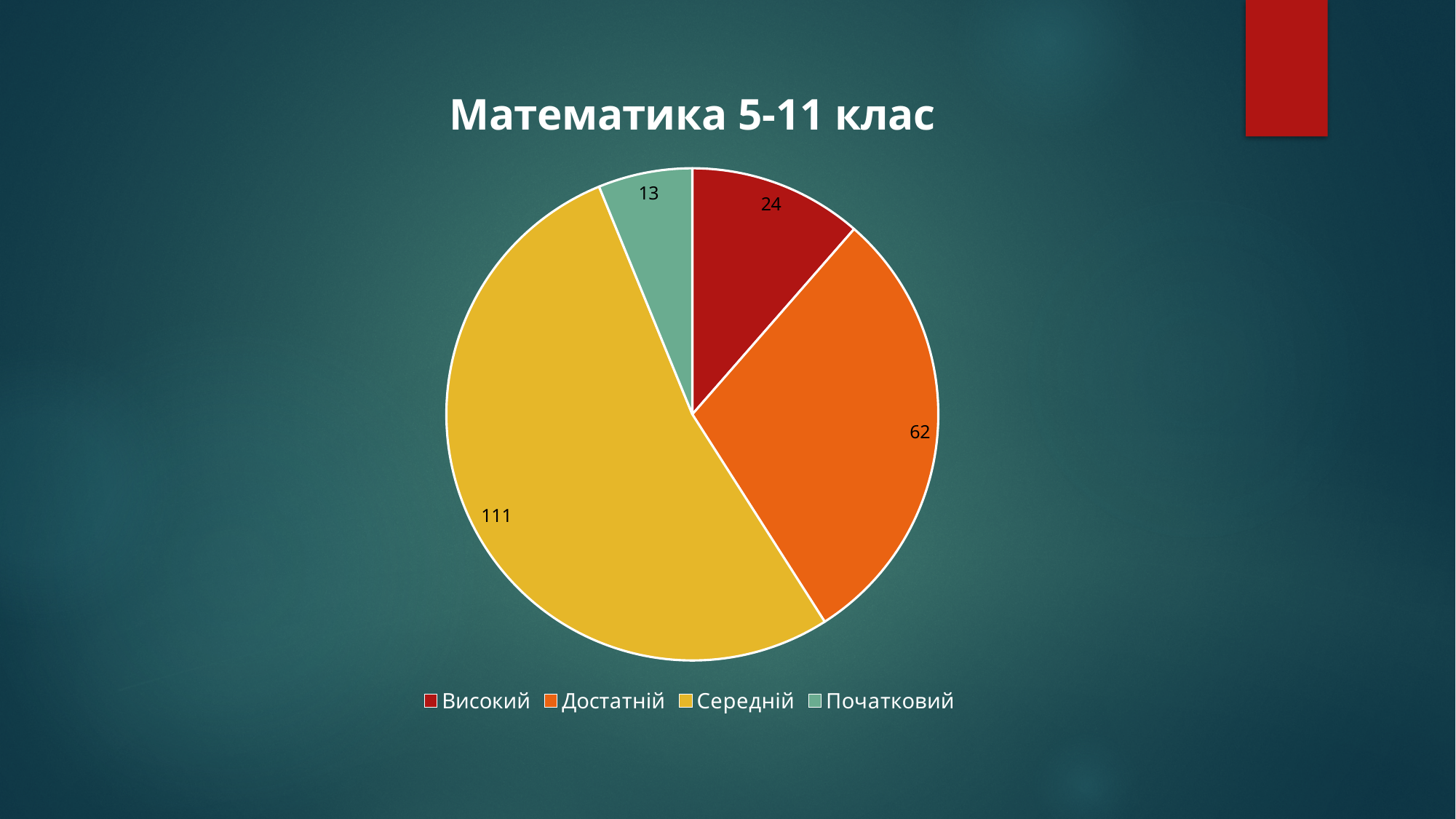
What is the value for Достатній? 62 What is the title of the chart? Математика 5-11 клас What is the value for Середній? 111 What is the value for Високий? 24 How many categories does the legend list? 4 What is the total of all slices in the pie? 210 What is the value for Початковий? 13 What type of chart is shown on the slide? pie chart Which is larger, the value for Високий or the value for Початковий? Високий Which category has the largest slice? Середній What is the difference between the values for Середній and Достатній? 49 Which category has the smallest slice? Початковий